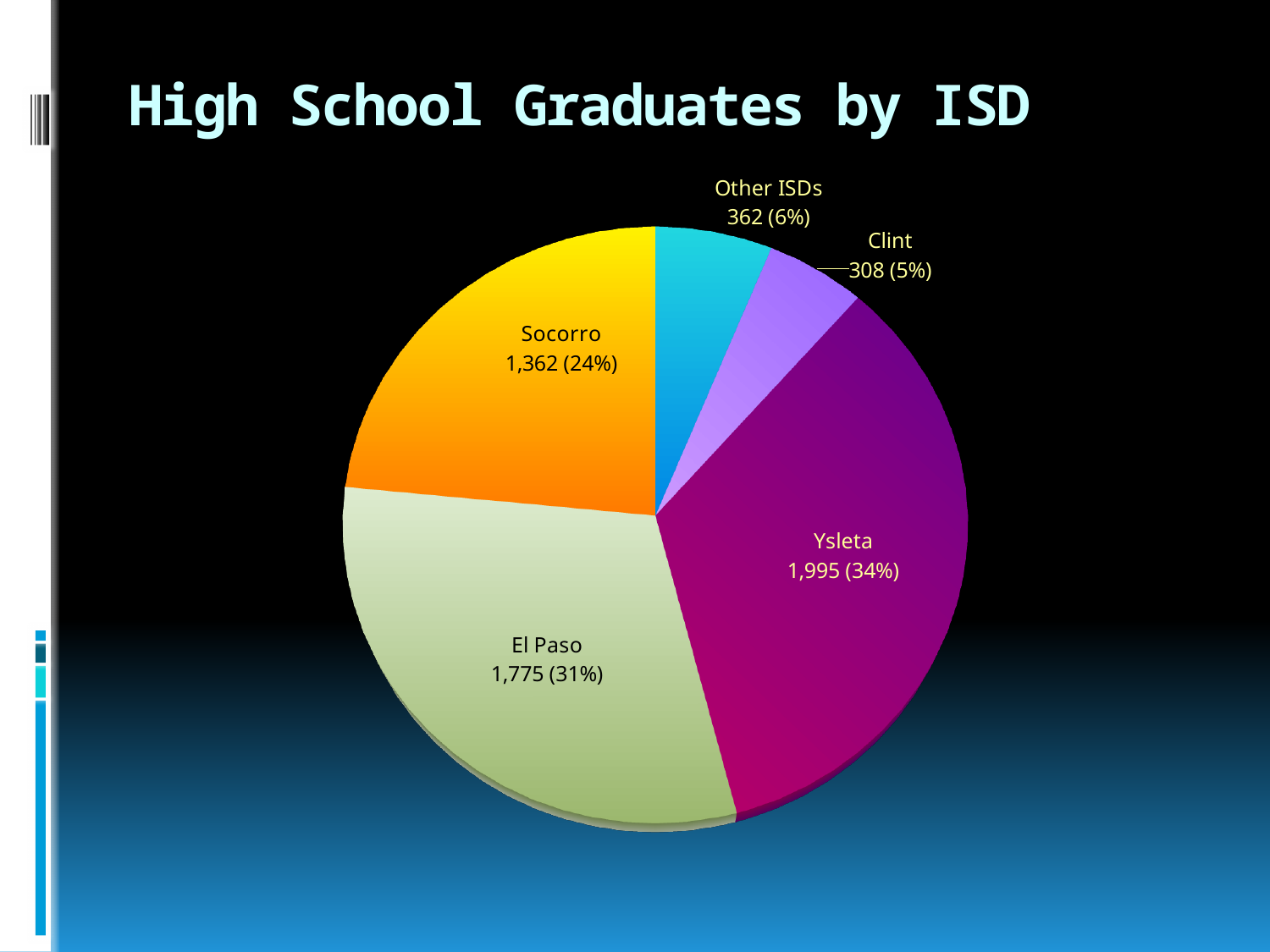
How many slices does the pie chart have? 5 What percentage share of the pie does El Paso have? 31% Which ISD has the smallest share of high school graduates? Clint What value is shown for Socorro? 1,362 What is the difference between the Ysleta and El Paso values? 220 What kind of chart is shown on the slide? pie chart How many high school graduates does the Ysleta slice show? 1,995 What is the title of the chart? High School Graduates by ISD Which ISD has the largest share of high school graduates? Ysleta What percentage share of the pie does Other ISDs have? 6% What value is shown for Clint? 308 Which is larger, the value for Socorro or the value for El Paso? El Paso